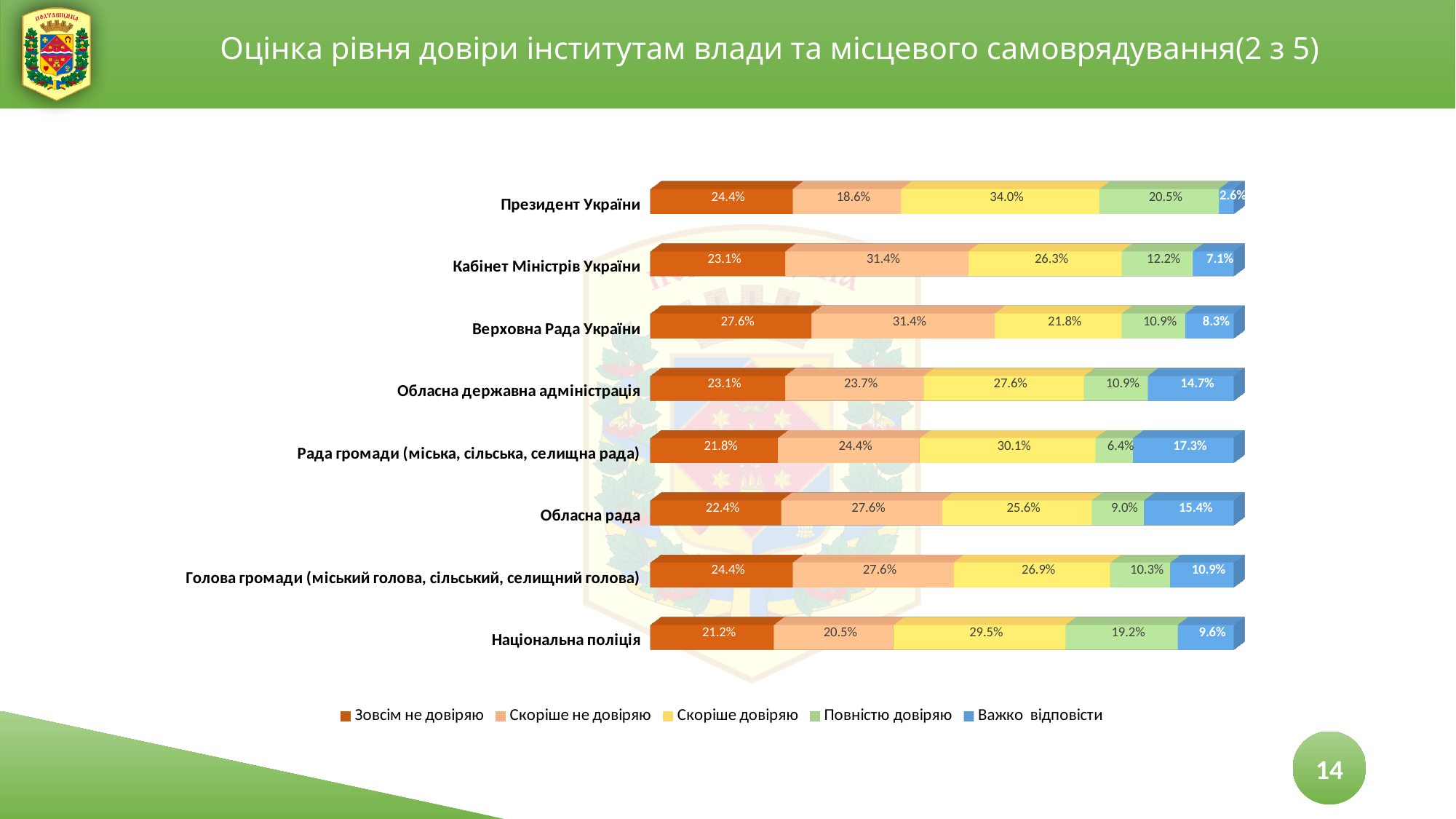
What is the value of "Скоріше не довіряю" for Верховна Рада України? 31.4% Which is larger: the "Скоріше не довіряю" value for Обласна рада or for Обласна державна адміністрація? Обласна рада What type of chart is shown on the slide? Stacked bar chart What is the value of "Повністю довіряю" for Національна поліція? 19.2% Which institution has the highest value for "Зовсім не довіряю"? Верховна Рада України What is the difference between the "Повністю довіряю" values for Президент України and Кабінет Міністрів України? 8.3% Which institution has the lowest value for "Важко відповісти"? Президент України What is the value of "Важко відповісти" for Рада громади (міська, сільська, селищна рада)? 17.3% What is the value of "Скоріше довіряю" for Президент України? 34.0% How many series does the legend list? 5 Which series is shown in blue in the legend? Важко відповісти How many institutions (categories) are shown in the chart? 8